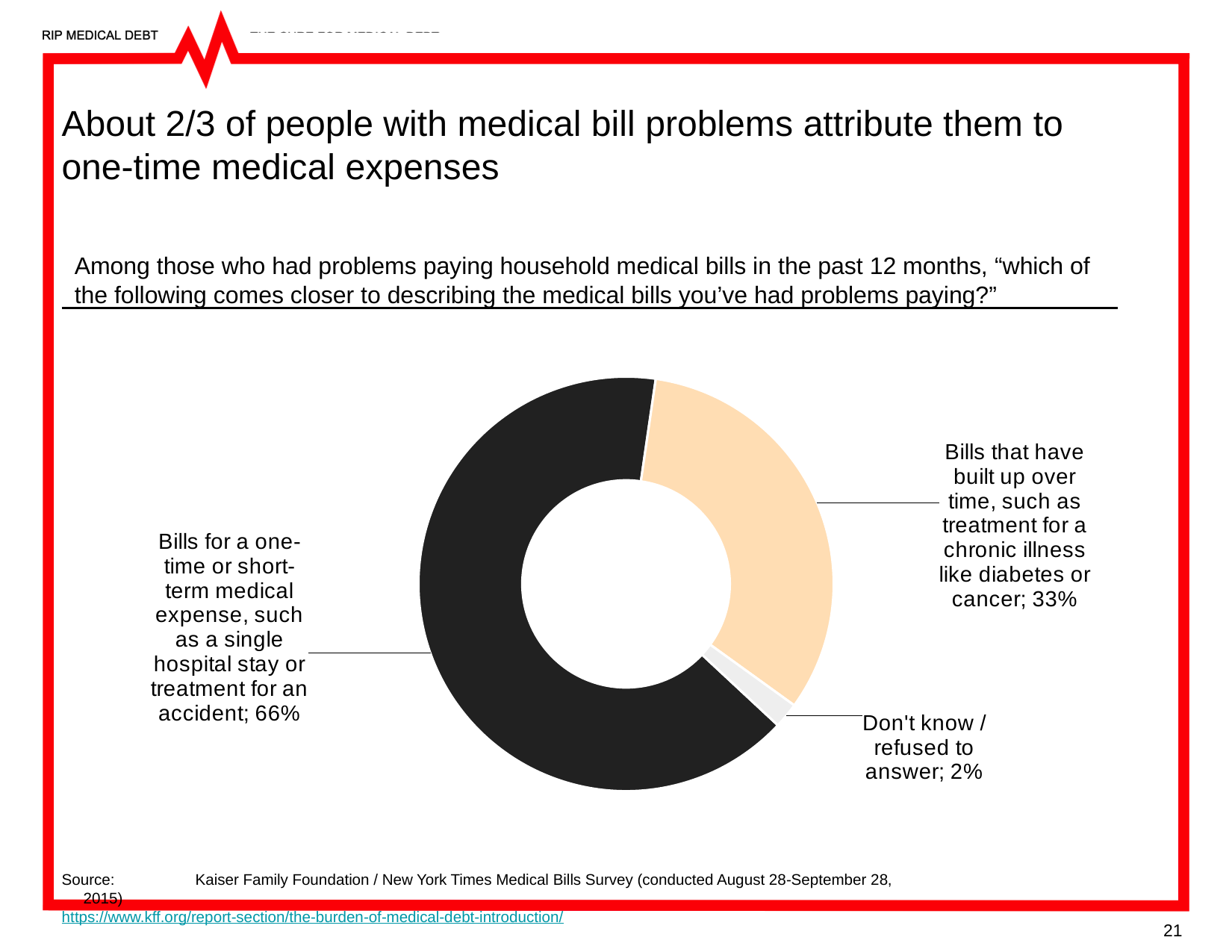
What is the difference in percentage points between the one-time expense share and the built-up-over-time share? 33 Which category has the largest share of the chart? Bills for a one-time or short-term medical expense What share of respondents answered 'Don't know / refused to answer'? 2% What colour is the slice for bills for a one-time or short-term medical expense? Black How many categories are shown in the chart? 3 Which category has the smallest share of the chart? Don't know / refused to answer What share of respondents attributed their medical bill problems to bills for a one-time or short-term medical expense? 66% Which is larger: the share for bills built up over time or the share for 'Don't know / refused to answer'? Bills built up over time What is the difference in percentage points between the built-up-over-time share and the 'Don't know / refused to answer' share? 31 What share of respondents attributed their medical bill problems to bills that have built up over time, such as treatment for a chronic illness? 33% Is the share for bills built up over time greater or less than 50%? less What kind of chart is shown on the slide? Doughnut (pie) chart